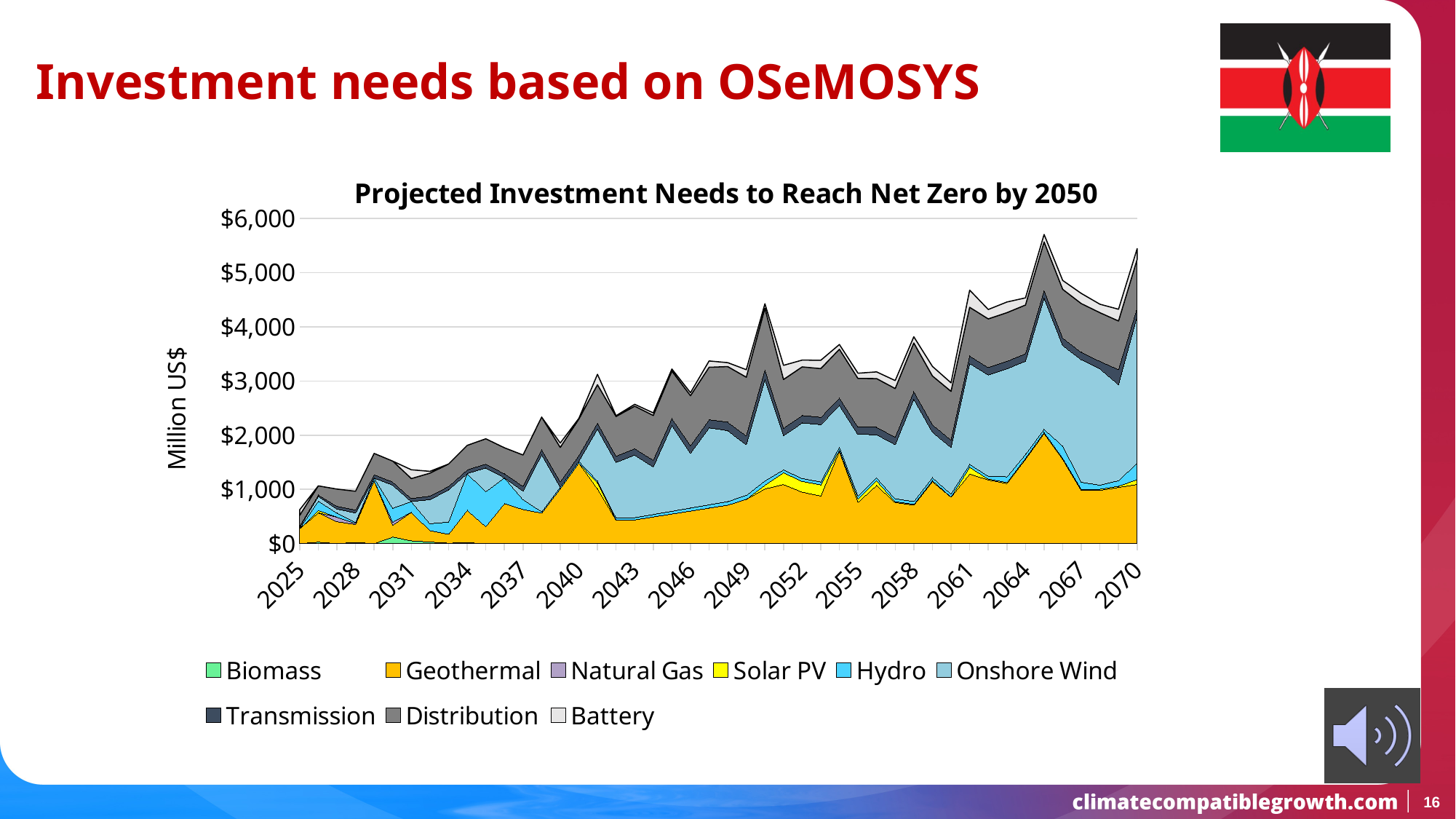
Is the total investment need in 2025 greater or less than $1,000 million? less How many series does the legend list? 9 Which year has the lowest total projected investment need? 2025 How many year labels are shown on the x axis? 16 Is the total investment need in 2034 greater or less than $1,000 million? greater What is the label on the vertical axis of the chart? Million US$ Is the total investment need in 2070 greater or less than $5,000 million? greater What kind of chart is shown on the slide? Stacked area chart Overall, do total projected investment needs rise or fall from 2025 to 2070? Rise What is the title of the chart? Projected Investment Needs to Reach Net Zero by 2050